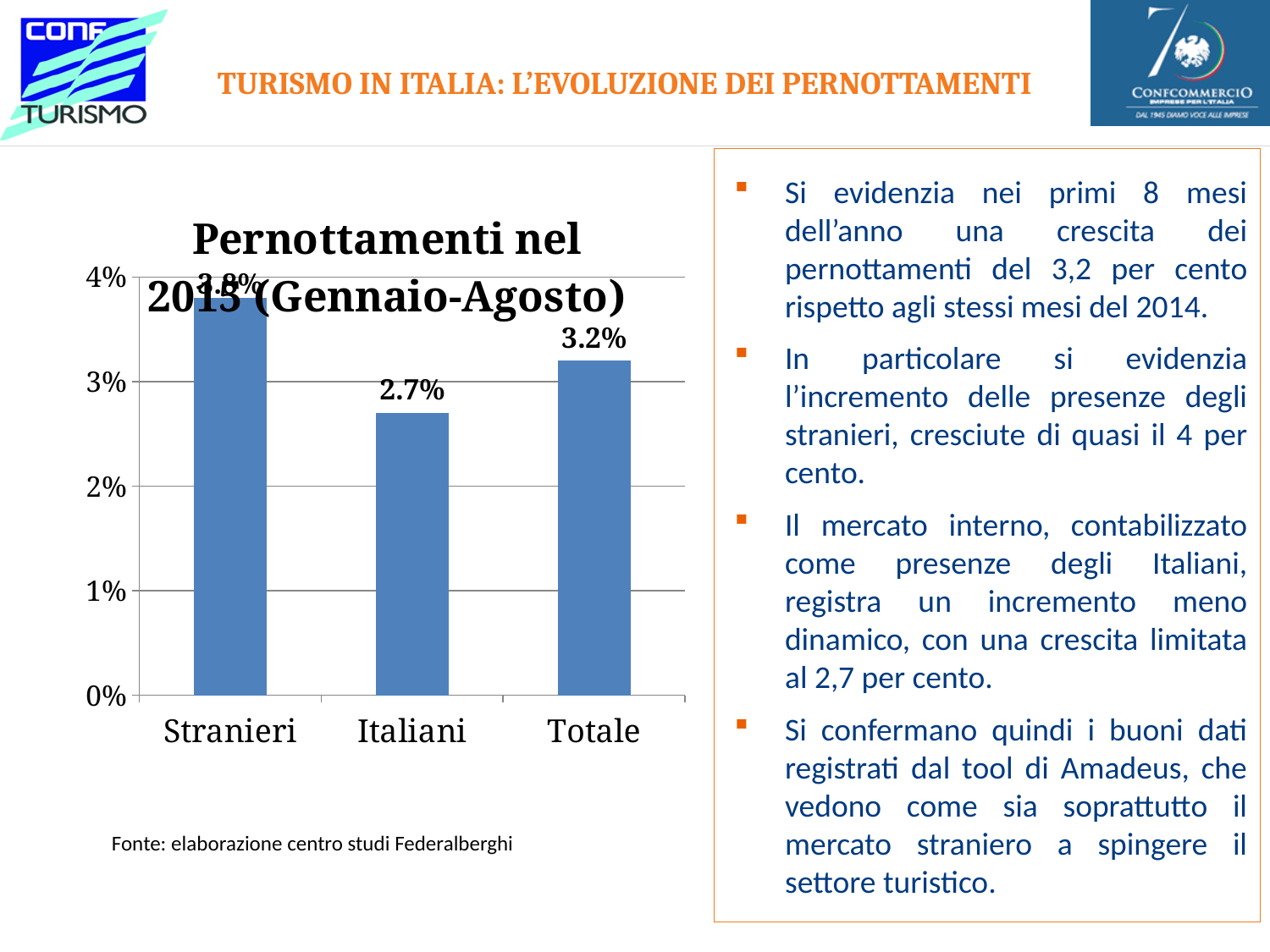
How many categories are shown in the chart? 3 Is the value for Italiani greater or less than 3%? less Is the value for Stranieri greater or less than 3%? greater Which category has the highest value in the chart? Stranieri What kind of chart is shown on the slide? bar chart Which is larger, the value for Stranieri or the value for Italiani? Stranieri What is the source cited below the chart? Fonte: elaborazione centro studi Federalberghi Which category has the lowest value in the chart? Italiani What is the value for Italiani in the chart? 2.7% What is the value for Totale in the chart? 3.2% What is the title of the chart? Pernottamenti nel 2015 (Gennaio-Agosto) What is the difference between the values for Totale and Italiani? 0.5%